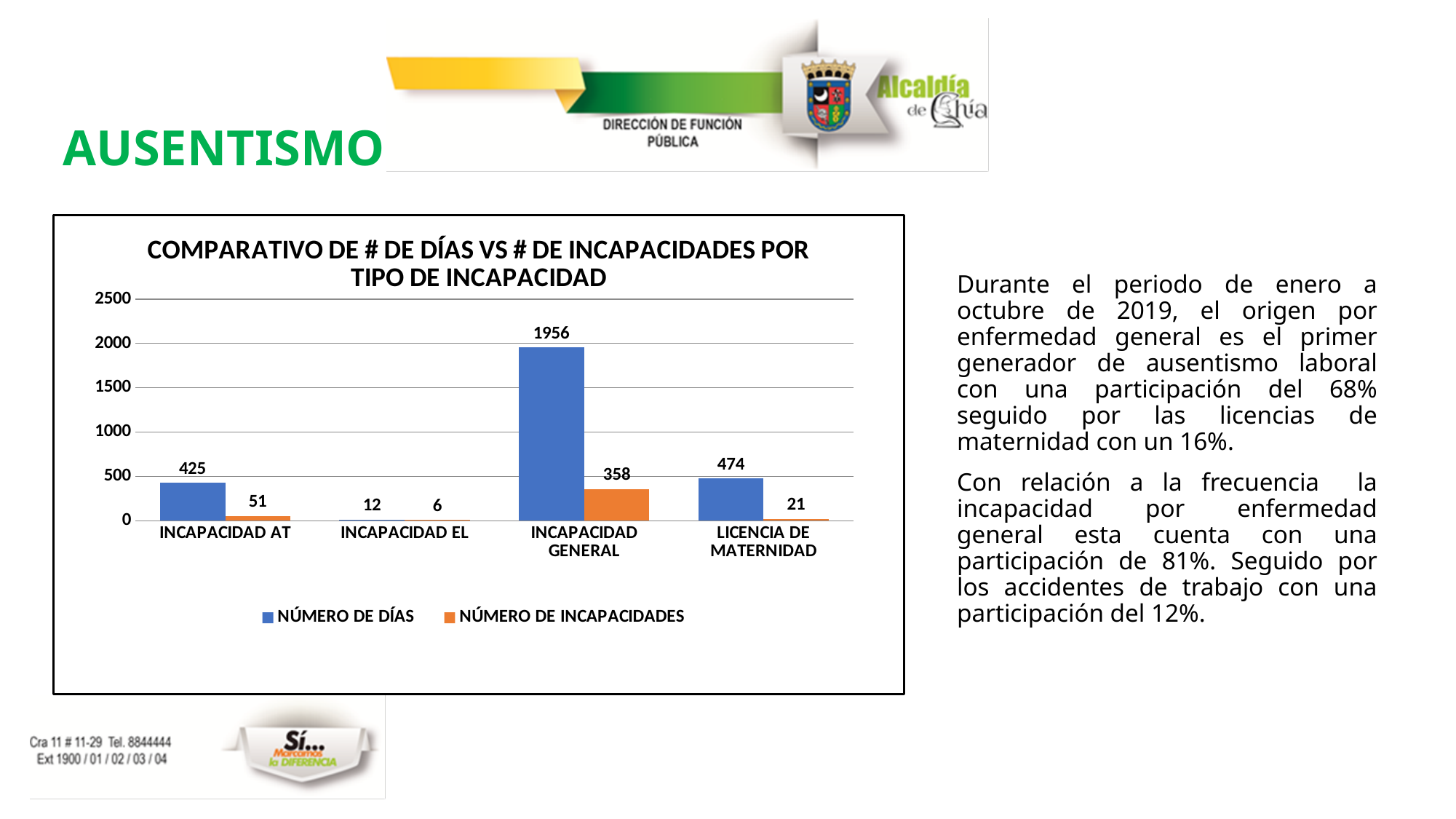
What is the NÚMERO DE DÍAS value for INCAPACIDAD GENERAL? 1956 Which category has the lowest NÚMERO DE INCAPACIDADES? INCAPACIDAD EL Which is larger: the NÚMERO DE DÍAS for INCAPACIDAD AT or for LICENCIA DE MATERNIDAD? LICENCIA DE MATERNIDAD Is the NÚMERO DE DÍAS value for INCAPACIDAD GENERAL greater or less than 1500? greater What is the NÚMERO DE INCAPACIDADES value for INCAPACIDAD AT? 51 What is the NÚMERO DE DÍAS value for LICENCIA DE MATERNIDAD? 474 What is the NÚMERO DE INCAPACIDADES value for INCAPACIDAD EL? 6 Which category has the highest NÚMERO DE DÍAS? INCAPACIDAD GENERAL What kind of chart is shown on the slide? bar chart What is the difference between the NÚMERO DE DÍAS for INCAPACIDAD GENERAL and for LICENCIA DE MATERNIDAD? 1482 How many categories are shown on the x axis of the chart? 4 How many series does the chart legend list? 2